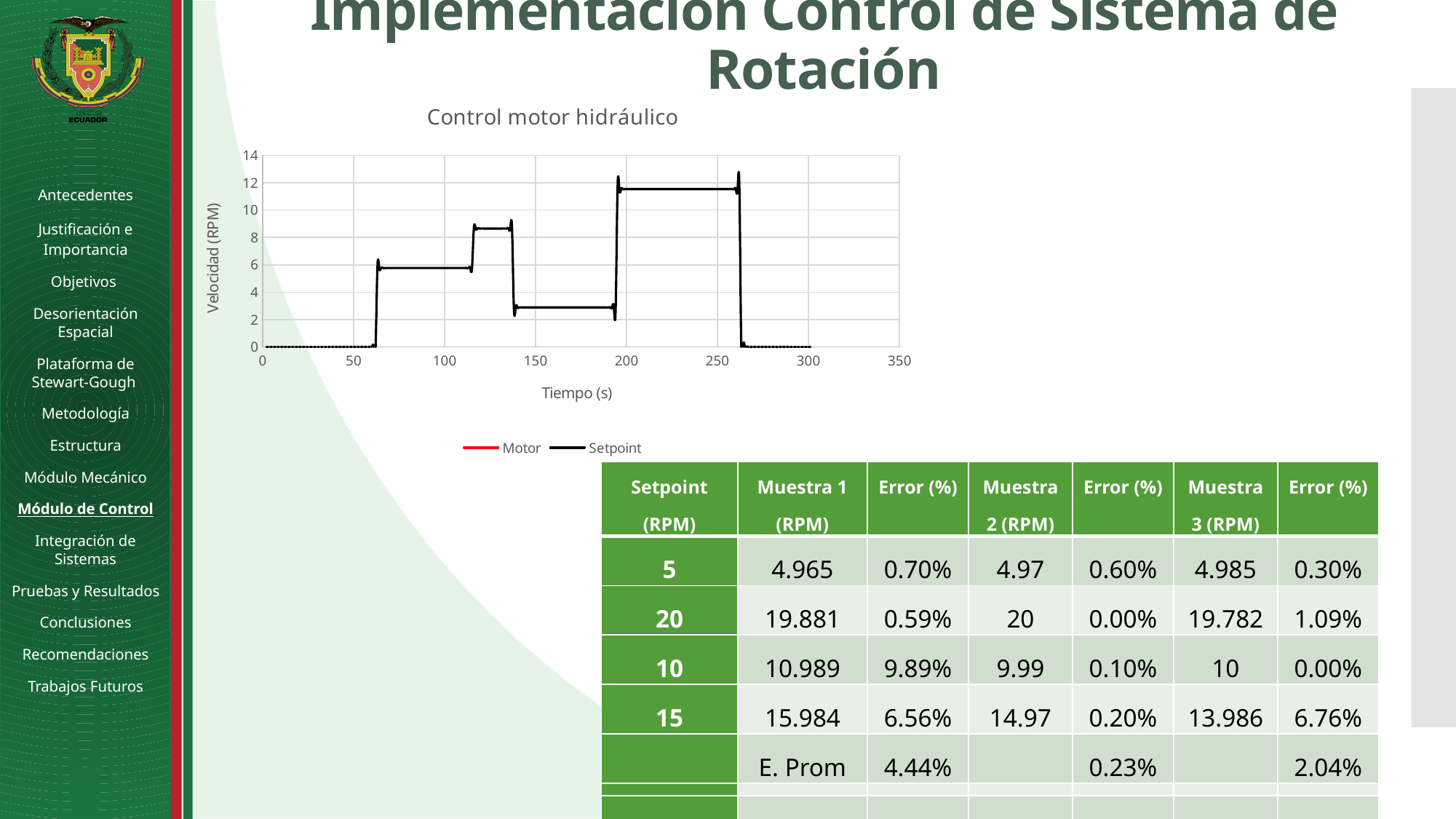
What is the title of the chart? Control motor hidráulico How many series does the chart legend list? 2 Is the value of the plotted line at 170 s greater or less than 4 RPM? less What label is on the x axis of the chart? Tiempo (s) Does the plotted line rise steadily, fall steadily, or go up and down across the x axis? up and down Is the value of the plotted line at 250 s greater or less than 10 RPM? greater What kind of chart is shown on the slide? line chart Is the value of the plotted line at 30 s greater or less than 2 RPM? less Which is larger, the value of the plotted line at 100 s or at 170 s? at 100 s Which is larger, the value of the plotted line at 125 s or at 225 s? at 225 s